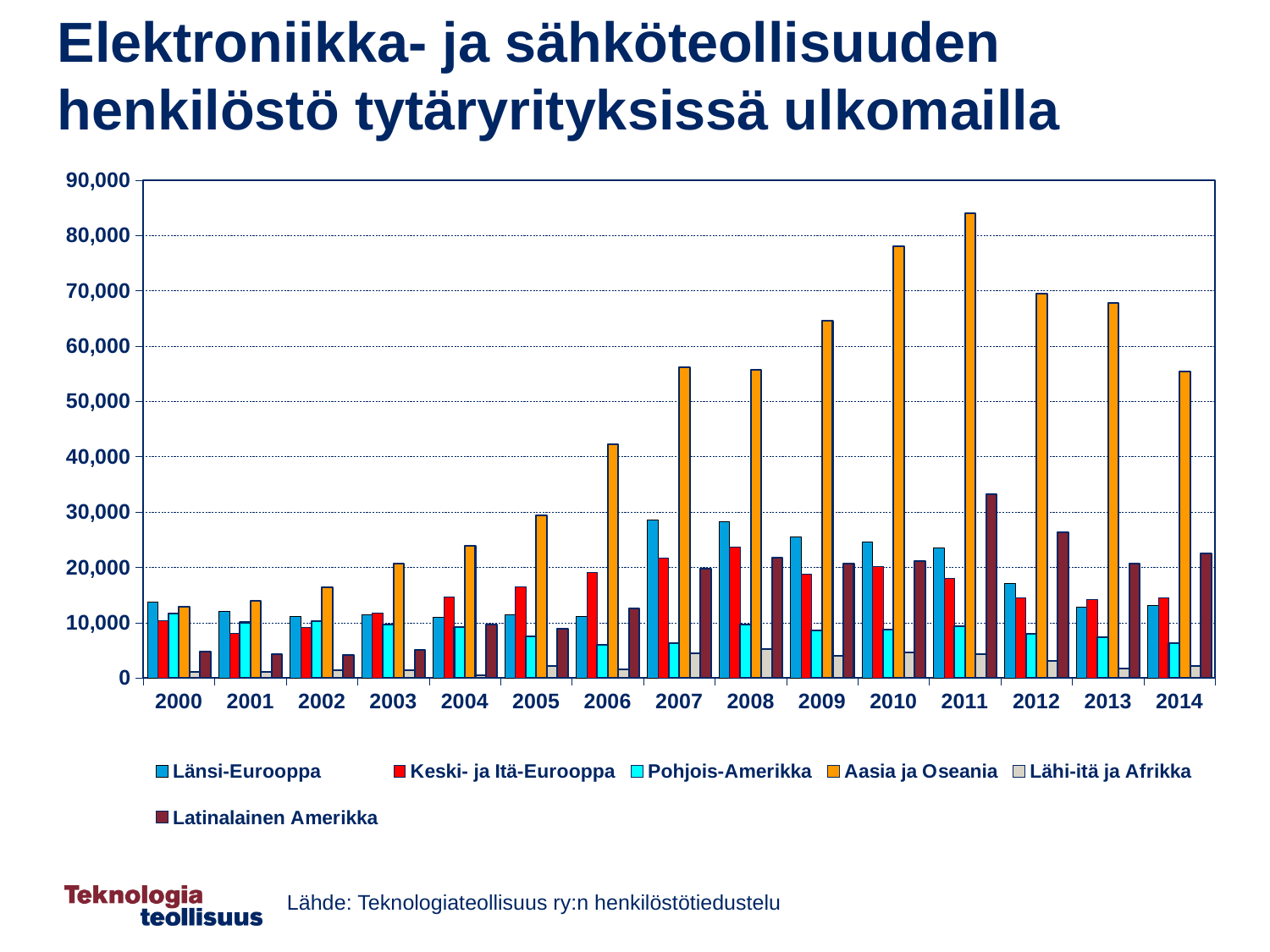
How many series does the legend list? 6 In 2014, which is larger: Aasia ja Oseania or Latinalainen Amerikka? Aasia ja Oseania How many years are shown on the x axis? 15 Is the value for Aasia ja Oseania in 2010 greater or less than 70,000? greater Do the values for Aasia ja Oseania rise or fall from 2000 to 2011? rise In which year is the value for Aasia ja Oseania highest? 2011 What kind of chart is shown on the slide? bar chart Is the value for Aasia ja Oseania in 2011 greater or less than 80,000? greater In 2011, which is larger: Latinalainen Amerikka or Keski- ja Itä-Eurooppa? Latinalainen Amerikka Is the value for Latinalainen Amerikka in 2011 greater or less than 30,000? greater Which series has the lowest value in 2014? Lähi-itä ja Afrikka